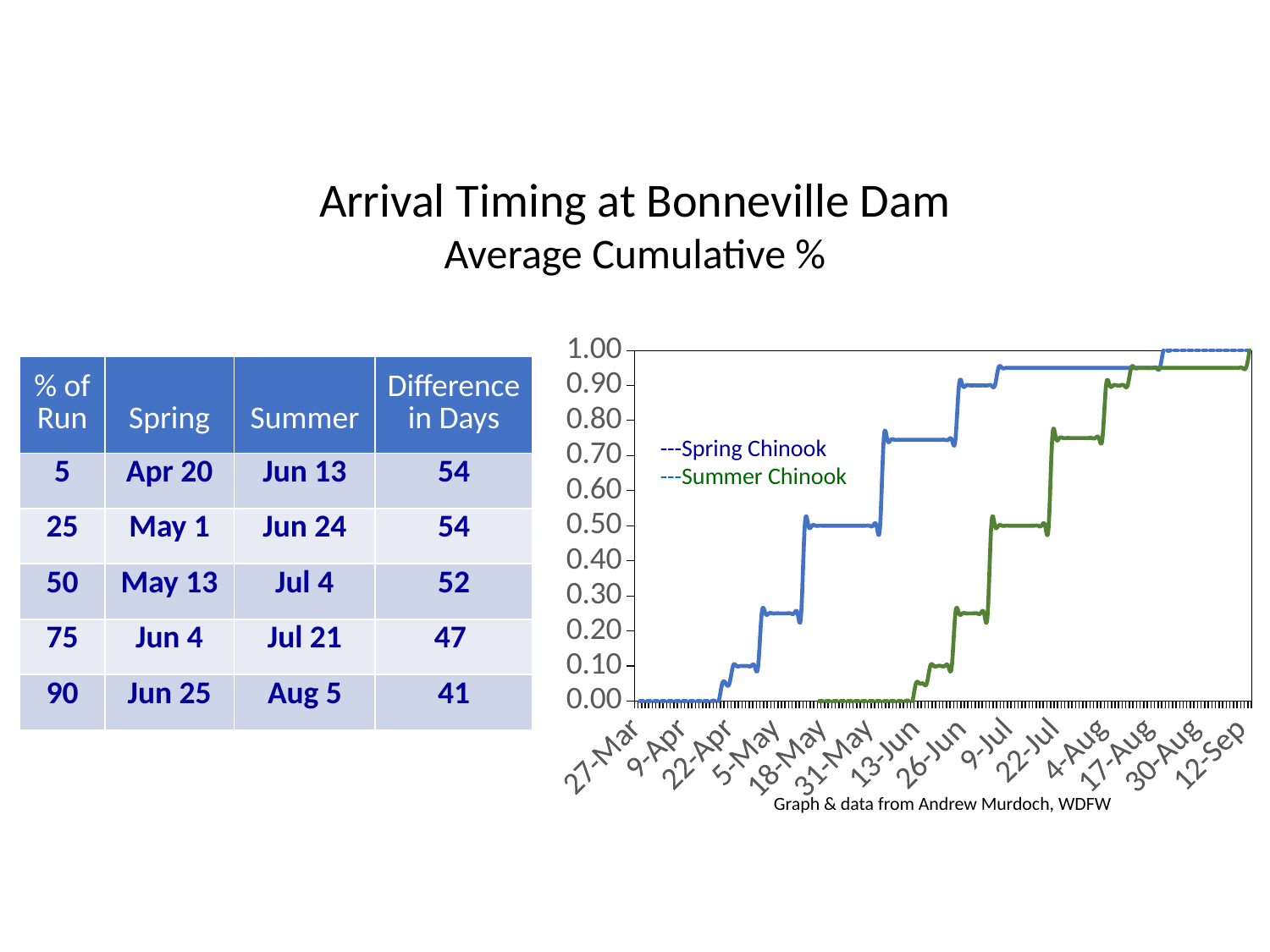
Is the Spring Chinook value at 9-Apr greater or less than 0.10? less How many series does the chart's legend list? 2 What are the two series named in the chart's legend? Spring Chinook and Summer Chinook Do the Spring Chinook values rise or fall along the x axis? rise Is the Summer Chinook value at 9-Jul greater or less than 0.40? greater What kind of chart is shown on the slide? line chart Is the Spring Chinook value at 18-May greater or less than 0.40? greater Which series reaches 0.50 earlier on the x axis, Spring Chinook or Summer Chinook? Spring Chinook At 13-Jun, which series has the higher value, Spring Chinook or Summer Chinook? Spring Chinook What colour is the Summer Chinook line in the chart? green